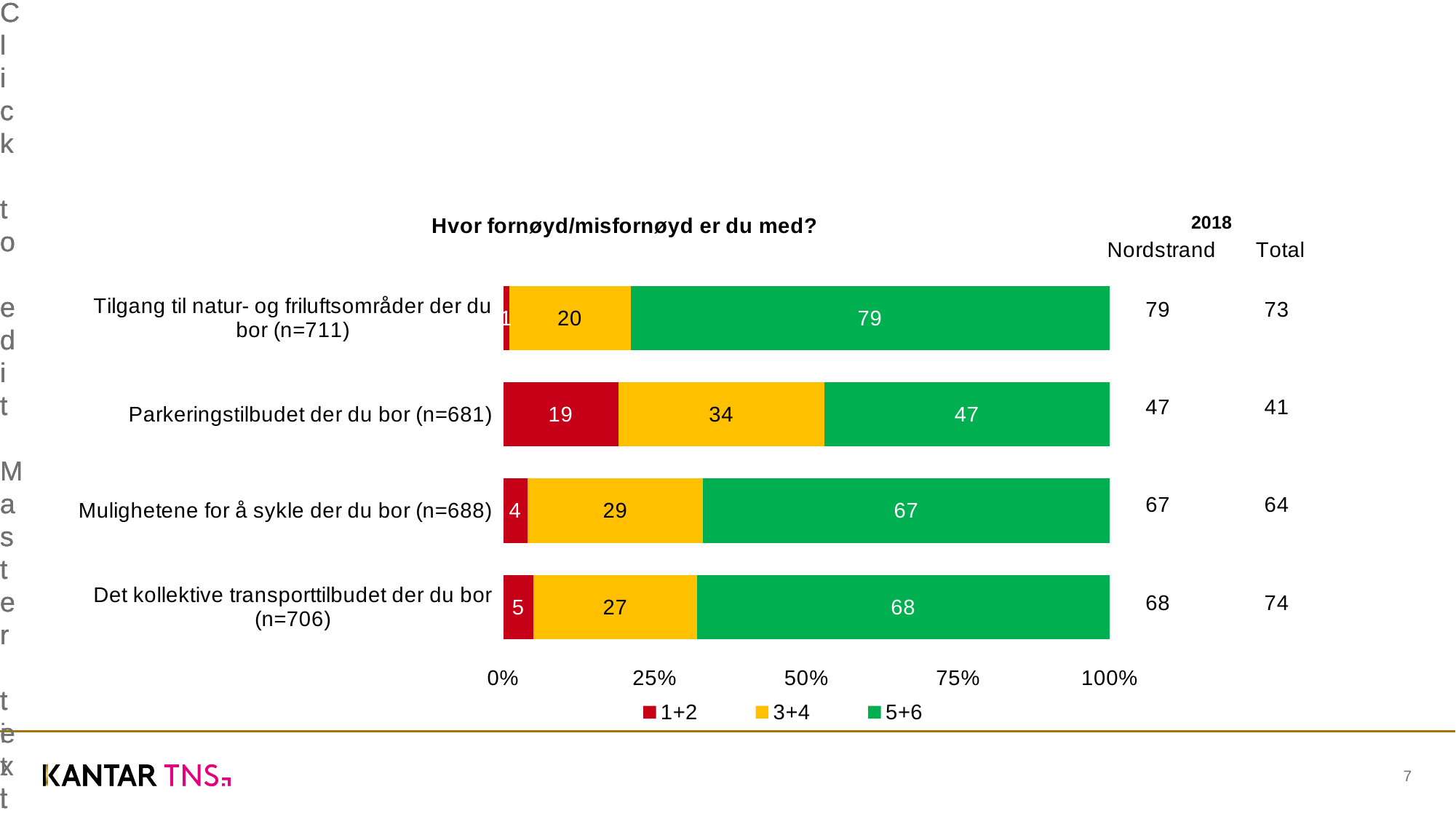
What is the difference between the 3+4 values for "Parkeringstilbudet der du bor (n=681)" and "Tilgang til natur- og friluftsområder der du bor (n=711)"? 14 What is the value of the 1+2 series for "Parkeringstilbudet der du bor (n=681)"? 19 What is the total of the stacked bar for "Parkeringstilbudet der du bor (n=681)"? 100 What is the value of the 3+4 series for "Mulighetene for å sykle der du bor (n=688)"? 29 Which category has the highest value for the 5+6 series? Tilgang til natur- og friluftsområder der du bor (n=711) How many categories are plotted in the chart? 4 Which is larger: the 1+2 value for "Det kollektive transporttilbudet der du bor (n=706)" or for "Mulighetene for å sykle der du bor (n=688)"? Det kollektive transporttilbudet der du bor (n=706) How many series does the legend list? 3 Which category has the lowest value for the 5+6 series? Parkeringstilbudet der du bor (n=681) What kind of chart is shown on the slide? Stacked bar chart What is the value of the 5+6 series for "Tilgang til natur- og friluftsområder der du bor (n=711)"? 79 What is the title of the chart? Hvor fornøyd/misfornøyd er du med?